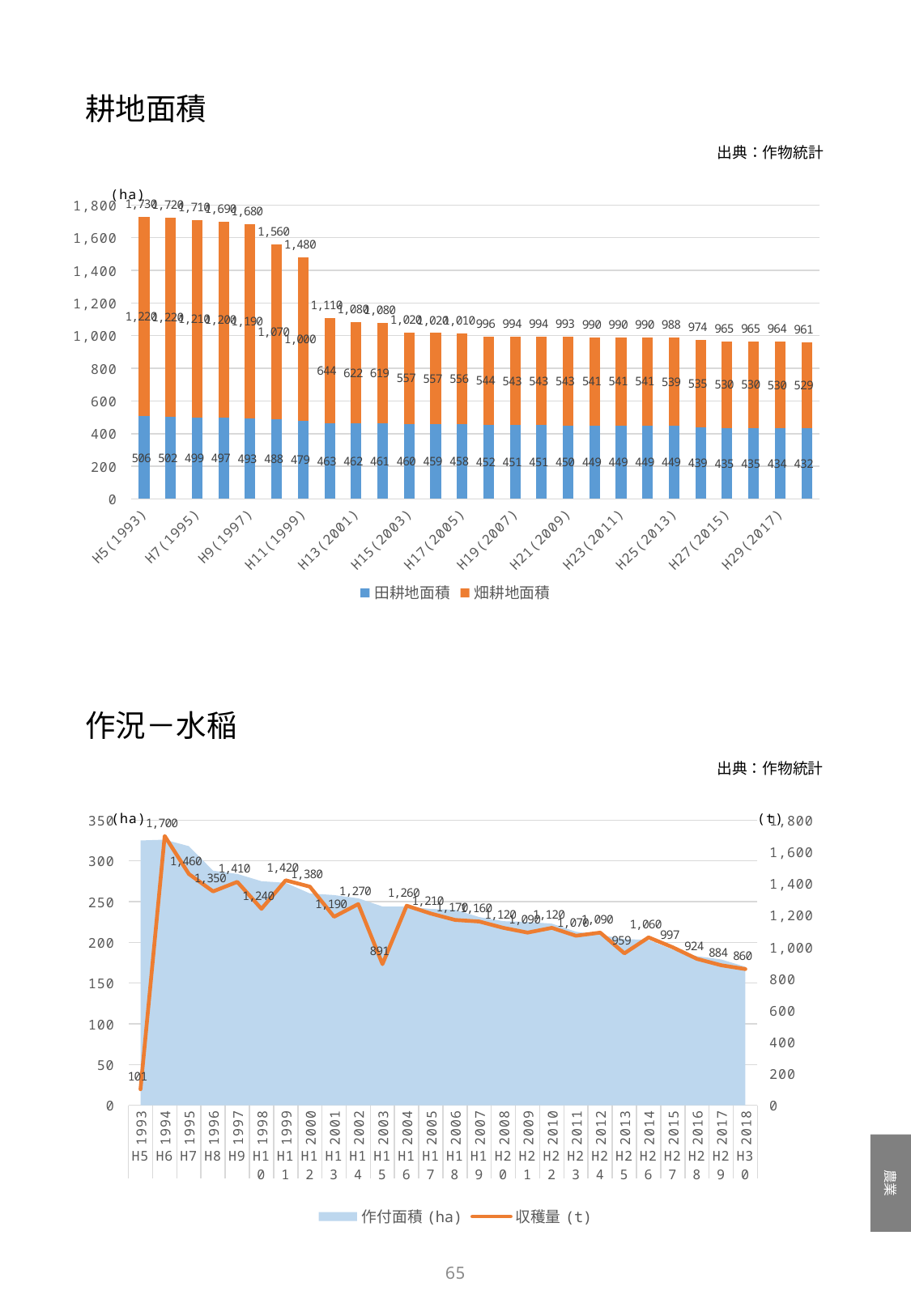
In the 作況－水稲 chart, is the 作付面積 (ha) value for 2018 greater or less than 200? less In the 作況－水稲 chart, which year has the larger 収穫量 (t), 2013 or 2014? 2014 How many series does the legend of the 耕地面積 chart list? 2 What kind of chart is the 耕地面積 chart? Stacked bar chart In the 耕地面積 chart, what is the total of the stacked bar for H5(1993)? 1,730 In the 耕地面積 chart, what is the difference between the 畑耕地面積 value for H5(1993) and for H29(2017)? 690 In the 作況－水稲 chart, which year has the highest 収穫量 (t)? 1994 In the 作況－水稲 chart, what is the 収穫量 (t) value for 2003? 891 In the 耕地面積 chart, what is the 田耕地面積 value for H5(1993)? 506 In the 作況－水稲 chart, which year has the lowest 収穫量 (t)? 1993 In the 耕地面積 chart, does the 畑耕地面積 series rise or fall from H5(1993) to H29(2017)? Fall In the 耕地面積 chart, what is the 畑耕地面積 value for H29(2017)? 530